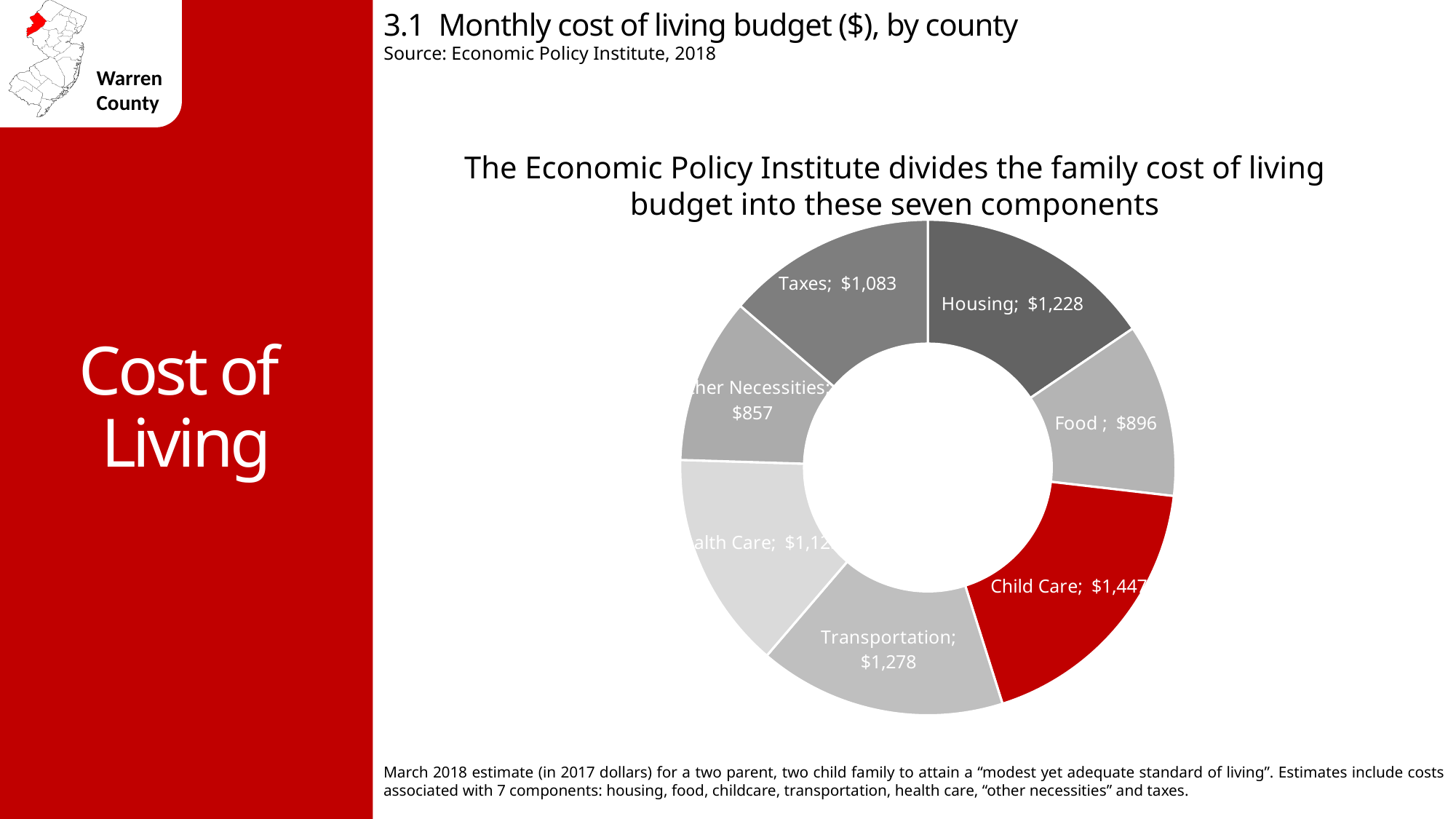
What is the monthly cost for Housing shown on the chart? $1,228 What is the monthly cost for Transportation shown on the chart? $1,278 How many components are shown in the chart? 7 What is the monthly cost for Food shown on the chart? $896 Which component has the highest monthly cost? Child Care What is the difference between the monthly cost of Transportation and Taxes? $195 What kind of chart is used on this slide? Doughnut (pie) chart Which is larger, the monthly cost of Housing or Transportation? Transportation How much more is the monthly cost of Child Care than Housing? $219 What is the monthly cost for Taxes shown on the chart? $1,083 What is the monthly cost for Child Care shown on the chart? $1,447 Which component has the lowest monthly cost? Other Necessities